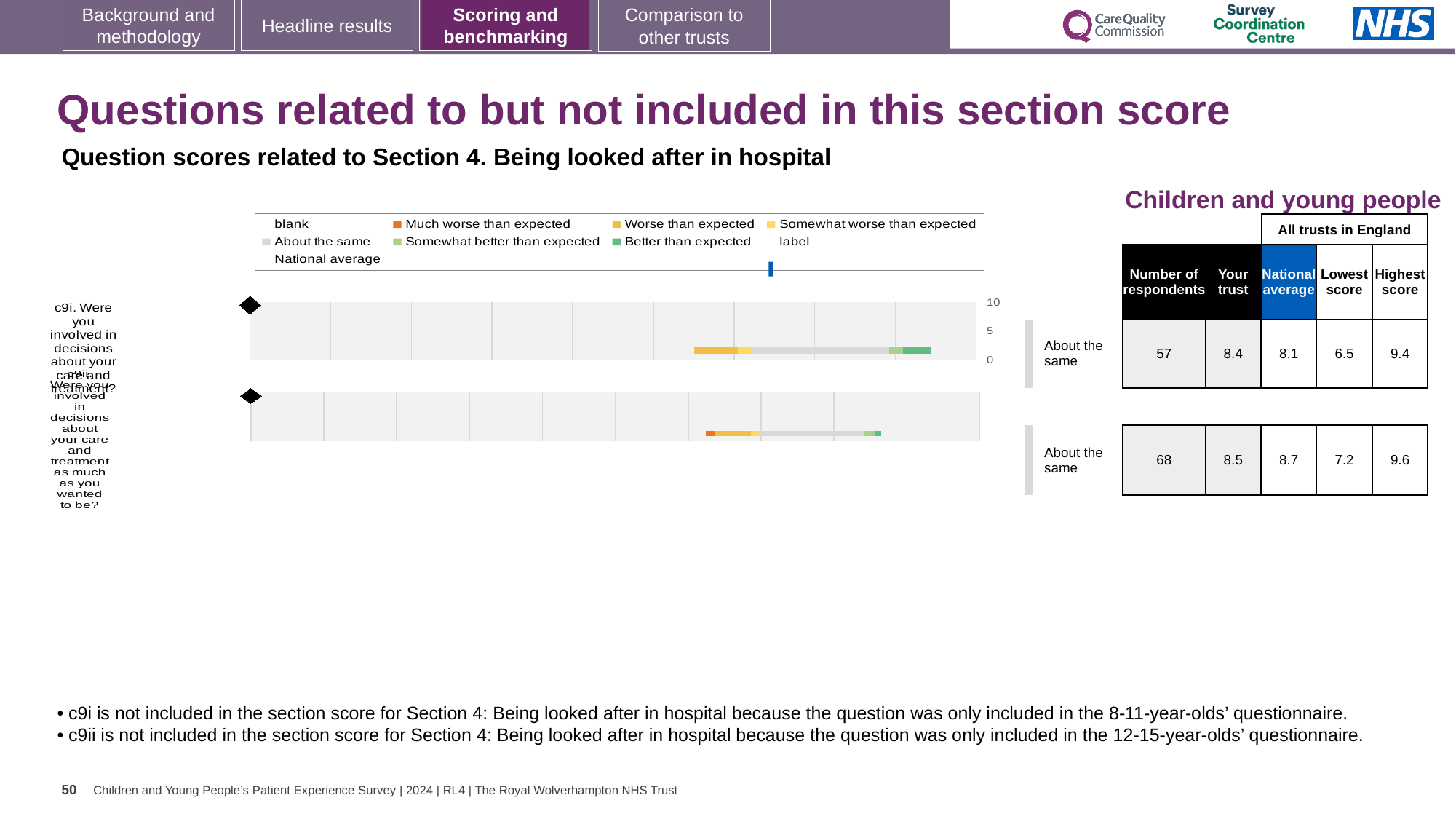
What is the maximum value shown on the chart's score axis? 10 Which benchmark category is shown next to the chart for c9i? About the same What type of chart is used to show the question scores for c9i and c9ii? bar chart For c9ii, which is higher: the 'Your trust' score or the national average? National average In the table beside the charts, what is the 'Your trust' score for c9i? 8.4 In the table beside the charts, what is the national average score for c9ii? 8.7 What colour represents 'Better than expected' in the chart legend? Green In the table beside the charts, how many respondents answered c9ii? 68 How many questions are plotted in the benchmark charts on this slide? 2 For c9i, which is higher: the 'Your trust' score or the national average? Your trust What is the difference between the highest score and the lowest score for c9i in the table? 2.9 Which benchmark category is shown next to the chart for c9ii? About the same